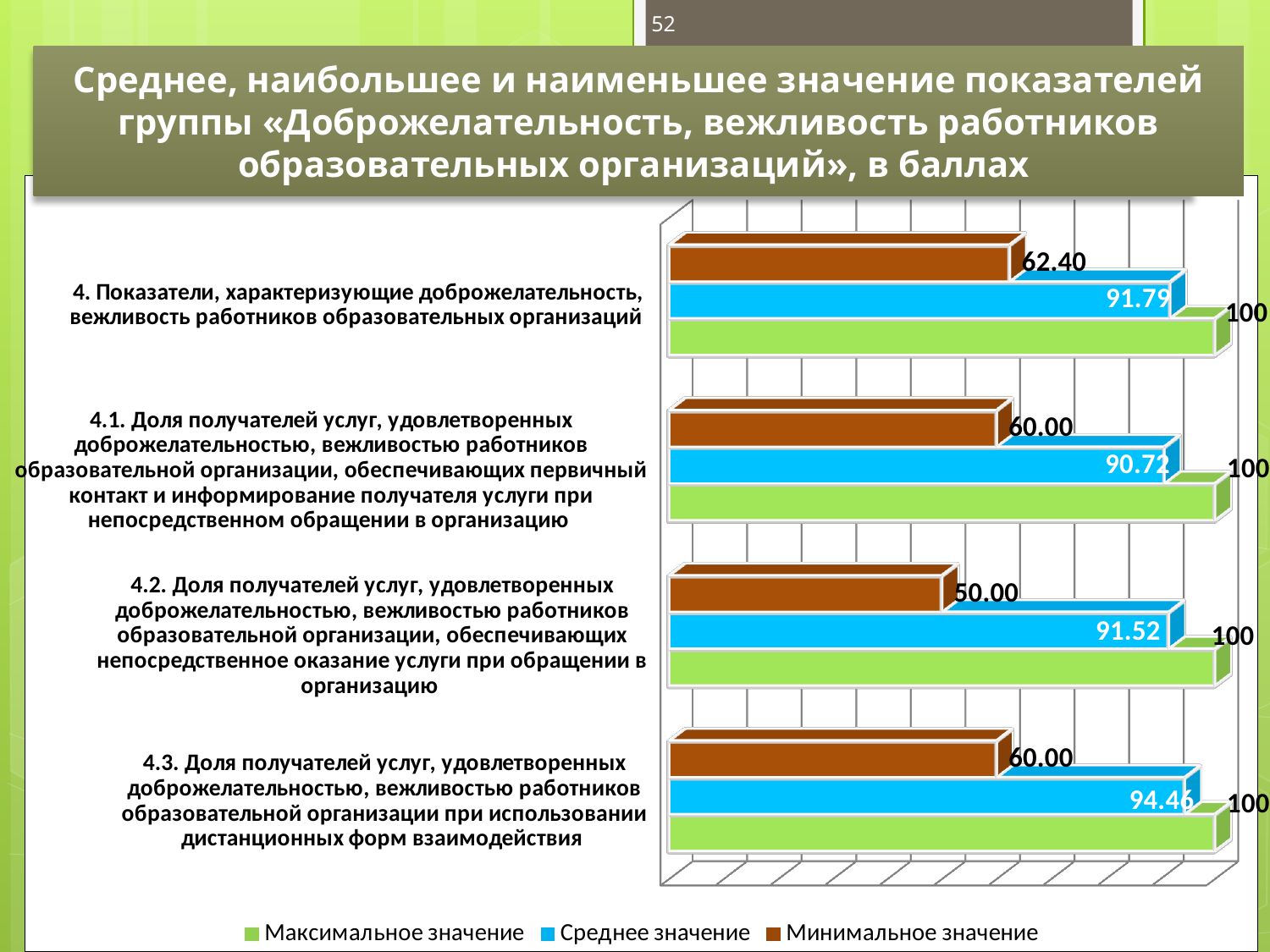
What is the average value (Среднее значение) for indicator 4 (Показатели, характеризующие доброжелательность, вежливость работников образовательных организаций)? 91.79 Which indicator has the highest minimum value (Минимальное значение)? 4 What is the difference between the minimum values of indicator 4 and indicator 4.1? 2.40 What is the difference between the maximum and minimum values for indicator 4.2? 50.00 What is the minimum value (Минимальное значение) for indicator 4.2? 50.00 Which is larger: the average value for indicator 4 or the average value for indicator 4.2? Indicator 4 (91.79) What is the minimum value (Минимальное значение) for indicator 4.1? 60.00 Which indicator has the lowest minimum value (Минимальное значение)? 4.2 How many indicators (categories) are shown in the chart? 4 What type of chart is shown on the slide? Bar chart What is the maximum value (Максимальное значение) for indicator 4.3? 100 How many series does the legend list? 3